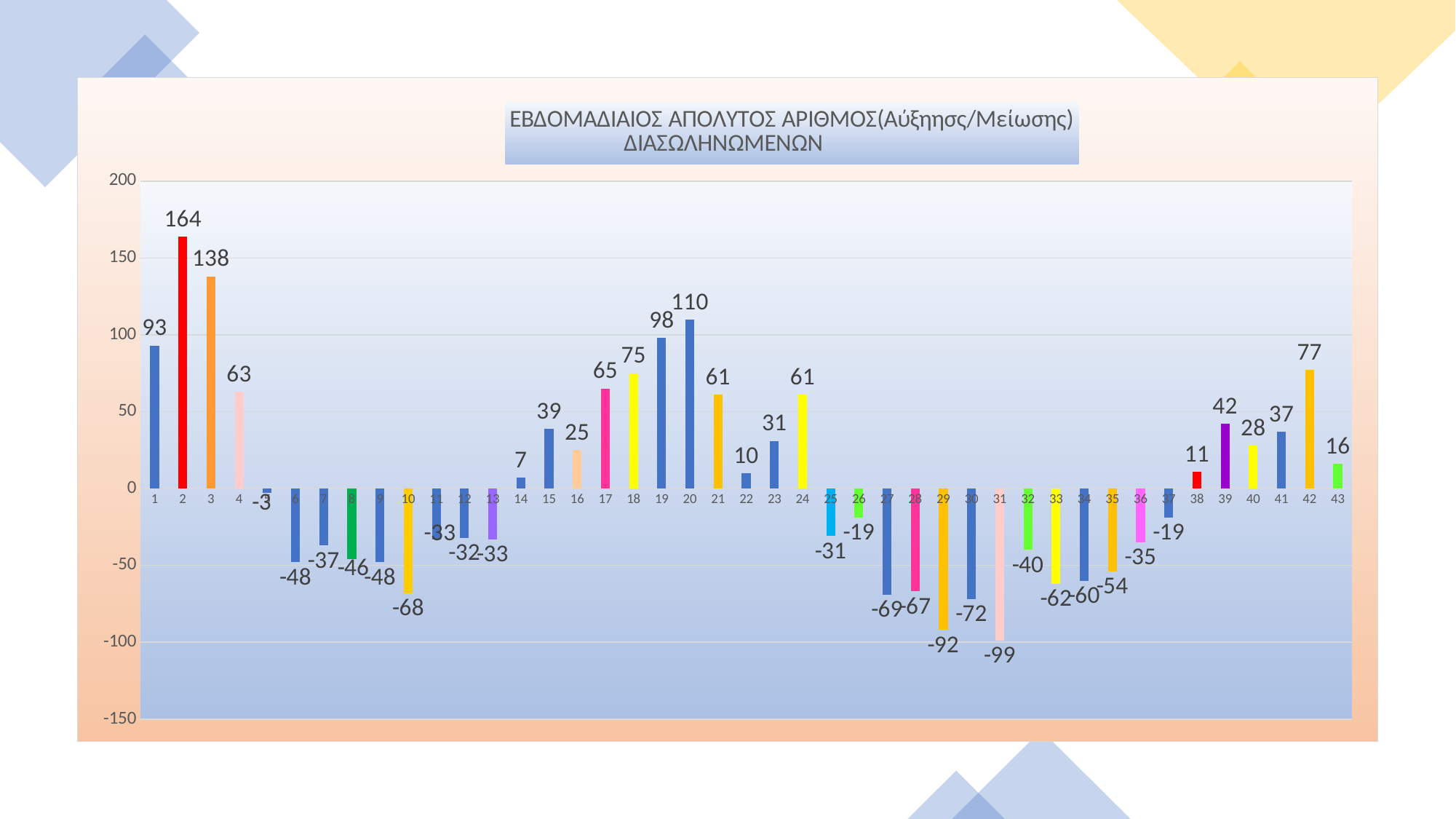
What is the difference between the values for category 19 and category 20? 12 What is the value for category 2? 164 Which category has the lowest value? 31 What is the value for category 31? -99 Which is larger, the value for category 17 or the value for category 18? category 18 What kind of chart is shown on the slide? bar chart How many categories are shown on the x axis? 43 What is the title of the chart? ΕΒΔΟΜΑΔΙΑΙΟΣ ΑΠΟΛΥΤΟΣ ΑΡΙΘΜΟΣ(Αύξηησς/Μείωσης) ΔΙΑΣΩΛΗΝΩΜΕΝΩΝ Which category has the highest value? 2 What is the difference between the values for category 2 and category 3? 26 What is the value for category 20? 110 What is the value for category 42? 77